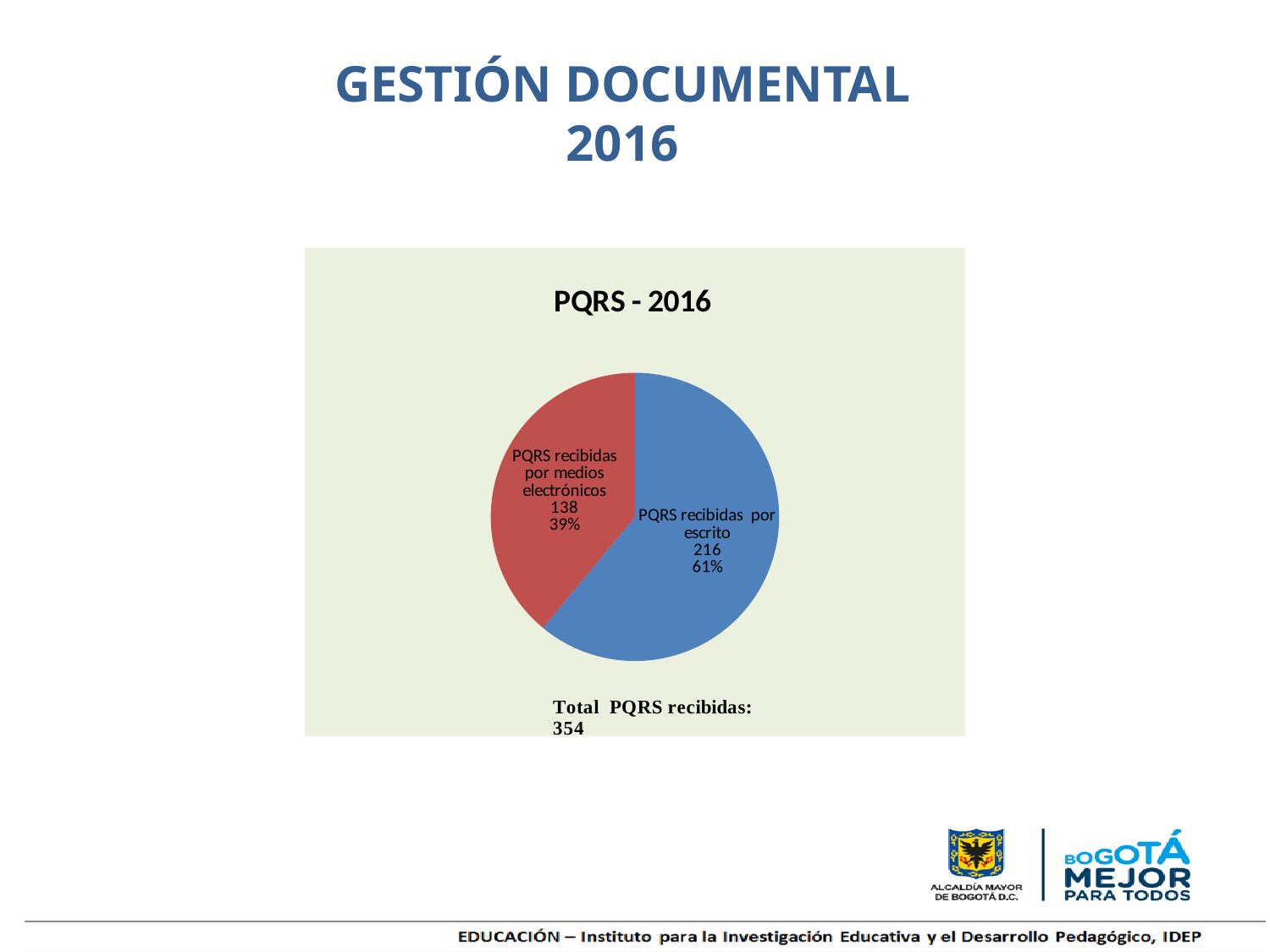
What share of the pie is PQRS recibidas por medios electrónicos? 39% How many slices does the pie chart have? 2 Which is larger, PQRS recibidas por escrito or PQRS recibidas por medios electrónicos? PQRS recibidas por escrito What is the value for PQRS recibidas por escrito? 216 What is the total number of PQRS recibidas shown on the chart? 354 Which category has the largest slice? PQRS recibidas por escrito What share of the pie is PQRS recibidas por escrito? 61% What is the difference between PQRS recibidas por escrito and PQRS recibidas por medios electrónicos? 78 What is the value for PQRS recibidas por medios electrónicos? 138 What is the title of the chart? PQRS - 2016 What kind of chart is shown on the slide? pie chart Which category has the smallest slice? PQRS recibidas por medios electrónicos